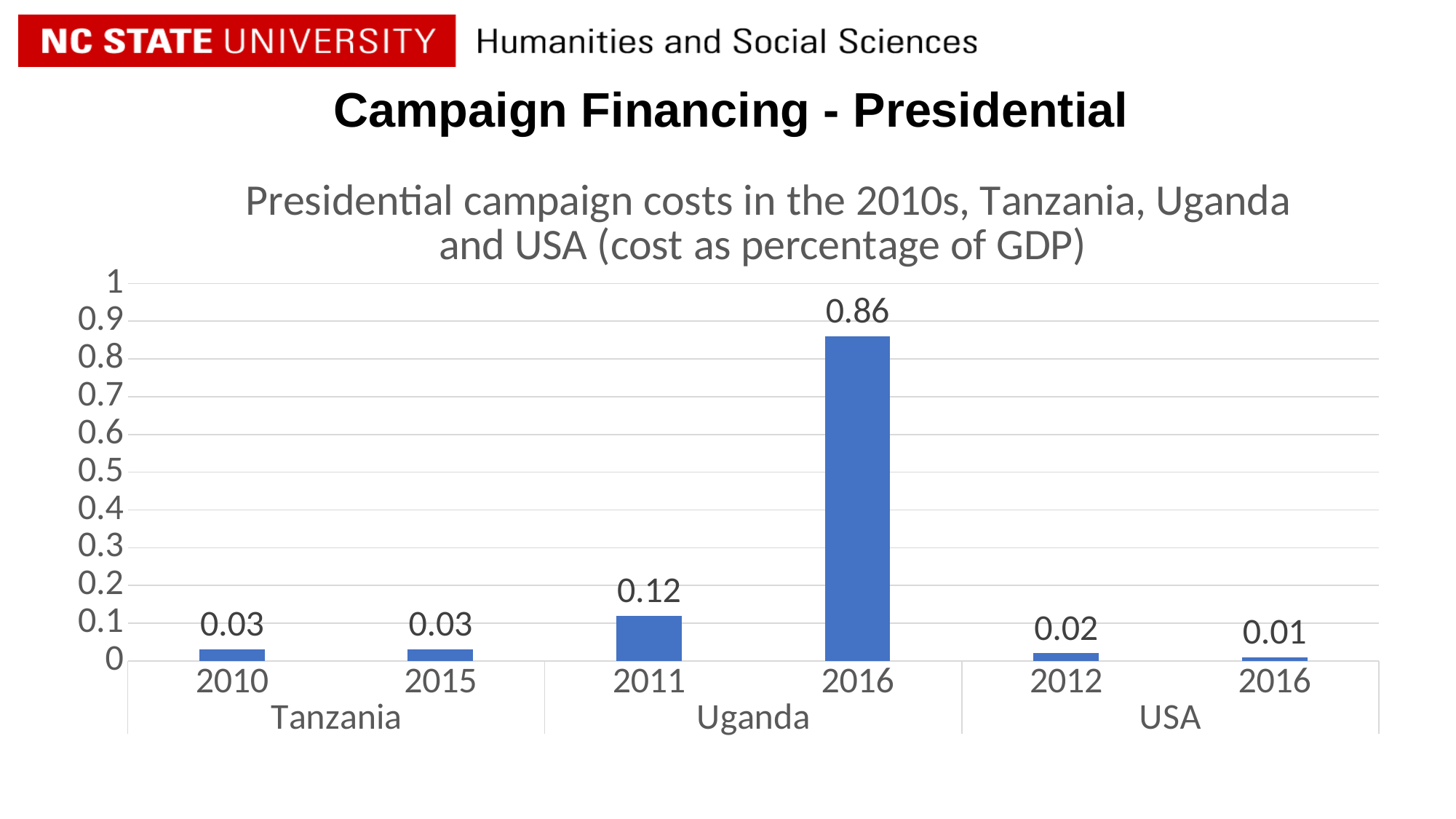
Is the value for Uganda in 2016 greater or less than 0.8? greater What kind of chart is shown? Bar chart What is the value for the USA in 2012? 0.02 What is the value for Uganda in 2016? 0.86 What is the difference between Uganda's 2016 and 2011 values? 0.74 How many bars are plotted in the chart? 6 What is the value for Uganda in 2011? 0.12 Which is larger, the value for Uganda in 2011 or the value for the USA in 2012? Uganda in 2011 What is the value for Tanzania in 2010? 0.03 What is the title of the chart? Presidential campaign costs in the 2010s, Tanzania, Uganda and USA (cost as percentage of GDP) Which bar has the lowest value? USA 2016 Which bar has the highest value? Uganda 2016